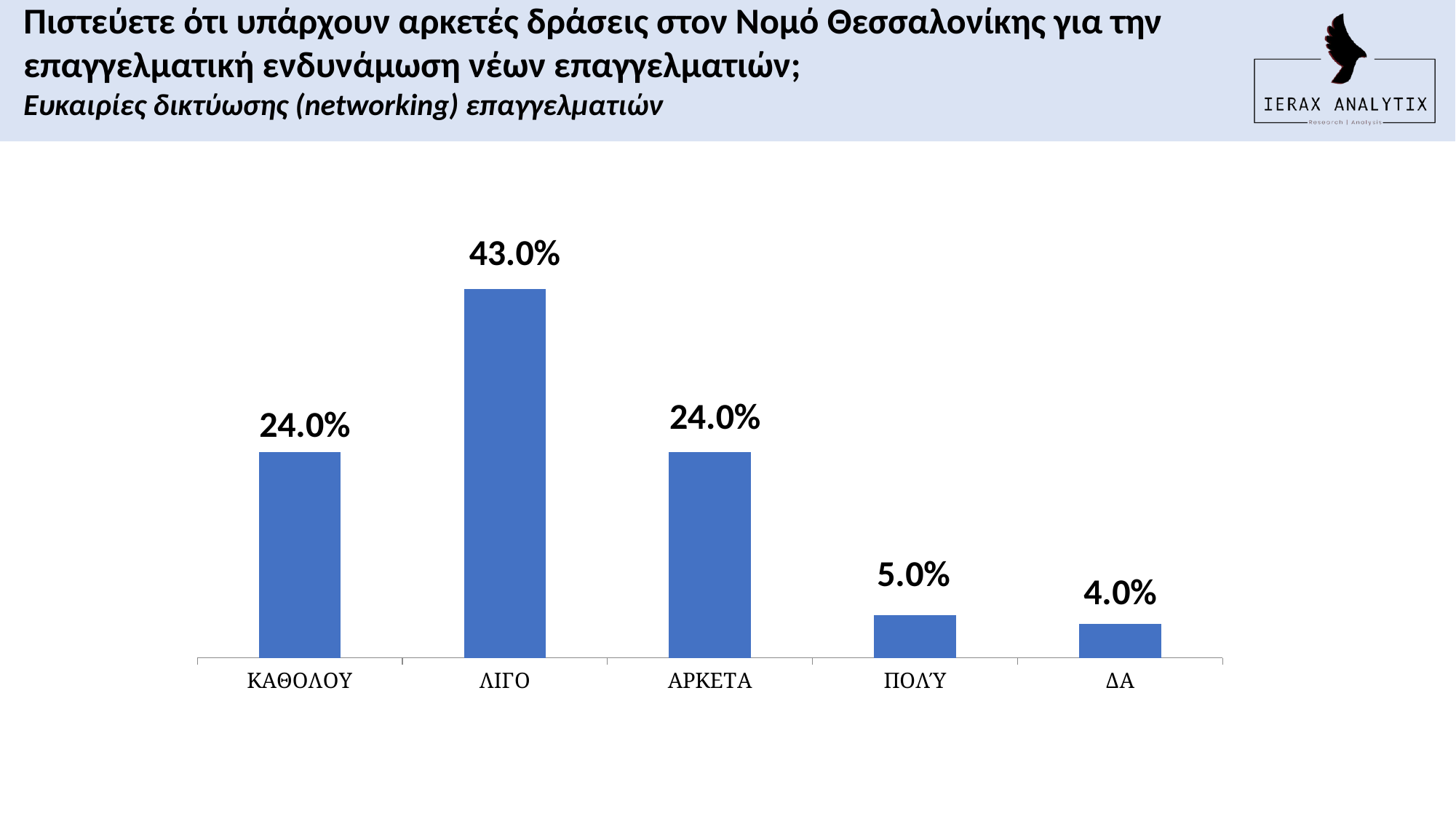
What is the value for ΔΑ? 4.0% Which is larger, the value for ΚΑΘΟΛΟΥ or the value for ΠΟΛΎ? ΚΑΘΟΛΟΥ What is the value for ΛΙΓΟ? 43.0% How many categories are shown on the x axis? 5 What kind of chart is shown on the slide? bar chart Which category has the highest value? ΛΙΓΟ What is the difference between the values for ΛΙΓΟ and ΑΡΚΕΤΑ? 19.0% What is the value for ΚΑΘΟΛΟΥ? 24.0% What is the value for ΠΟΛΎ? 5.0% Which category has the lowest value? ΔΑ What is the subtitle of the chart shown in italics below the question? Ευκαιρίες δικτύωσης (networking) επαγγελματιών What is the difference between the values for ΠΟΛΎ and ΔΑ? 1.0%